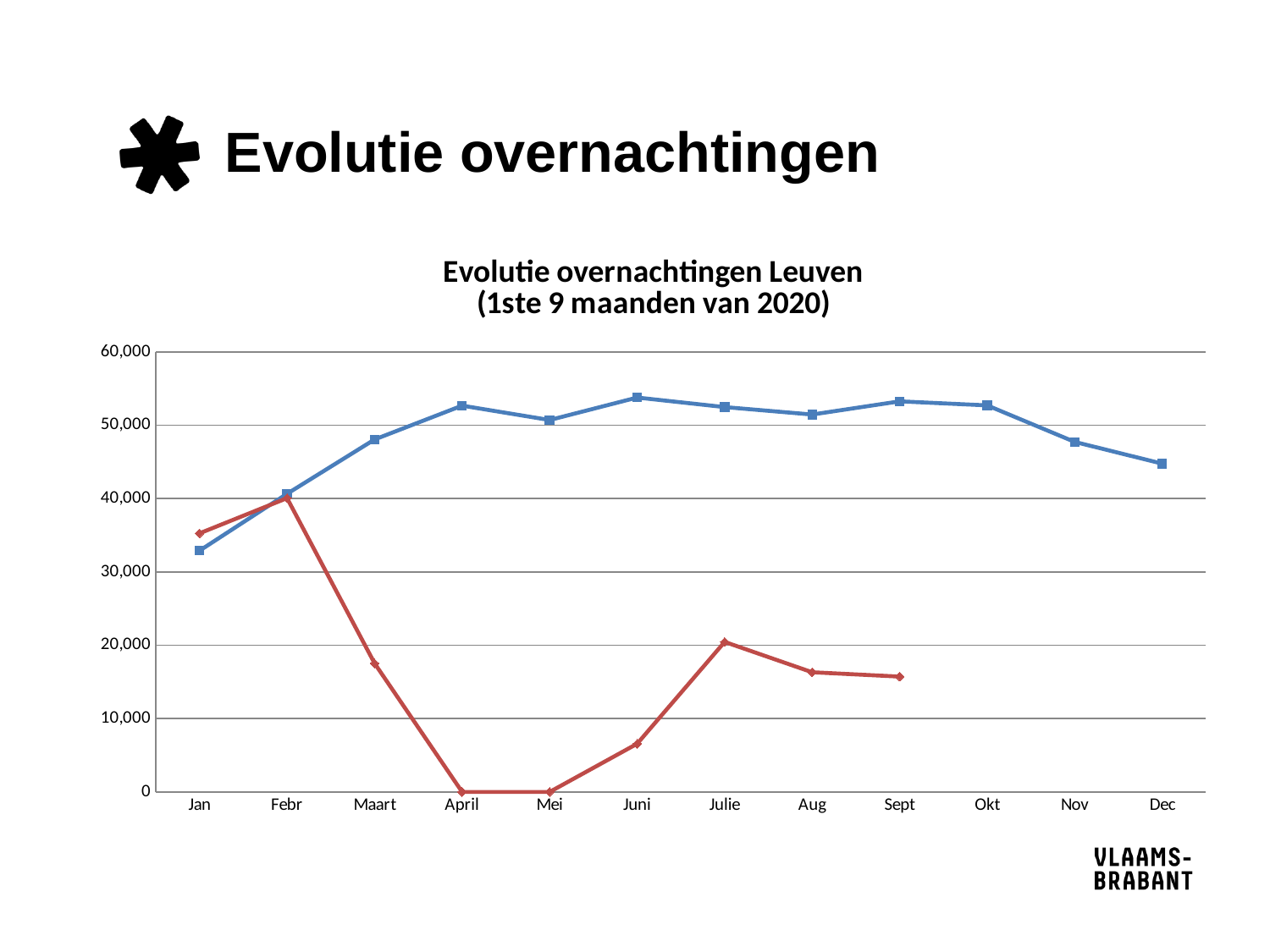
Is the value of the blue line for Juni greater or less than 50,000? greater How many months are shown on the x axis of the chart? 12 What kind of chart is shown on the slide? line chart Is the value of the blue line for Dec greater or less than 40,000? greater What is the title of the chart? Evolutie overnachtingen Leuven (1ste 9 maanden van 2020) In which month is the red line at its highest? Febr Is the value of the red line for Maart greater or less than 20,000? less In which month does the red line end? Sept In which month is the blue line at its lowest? Jan How many data points does the red line have? 9 Which line has the higher value in Maart, the blue line or the red line? the blue line In which months does the red line reach 0? April and Mei